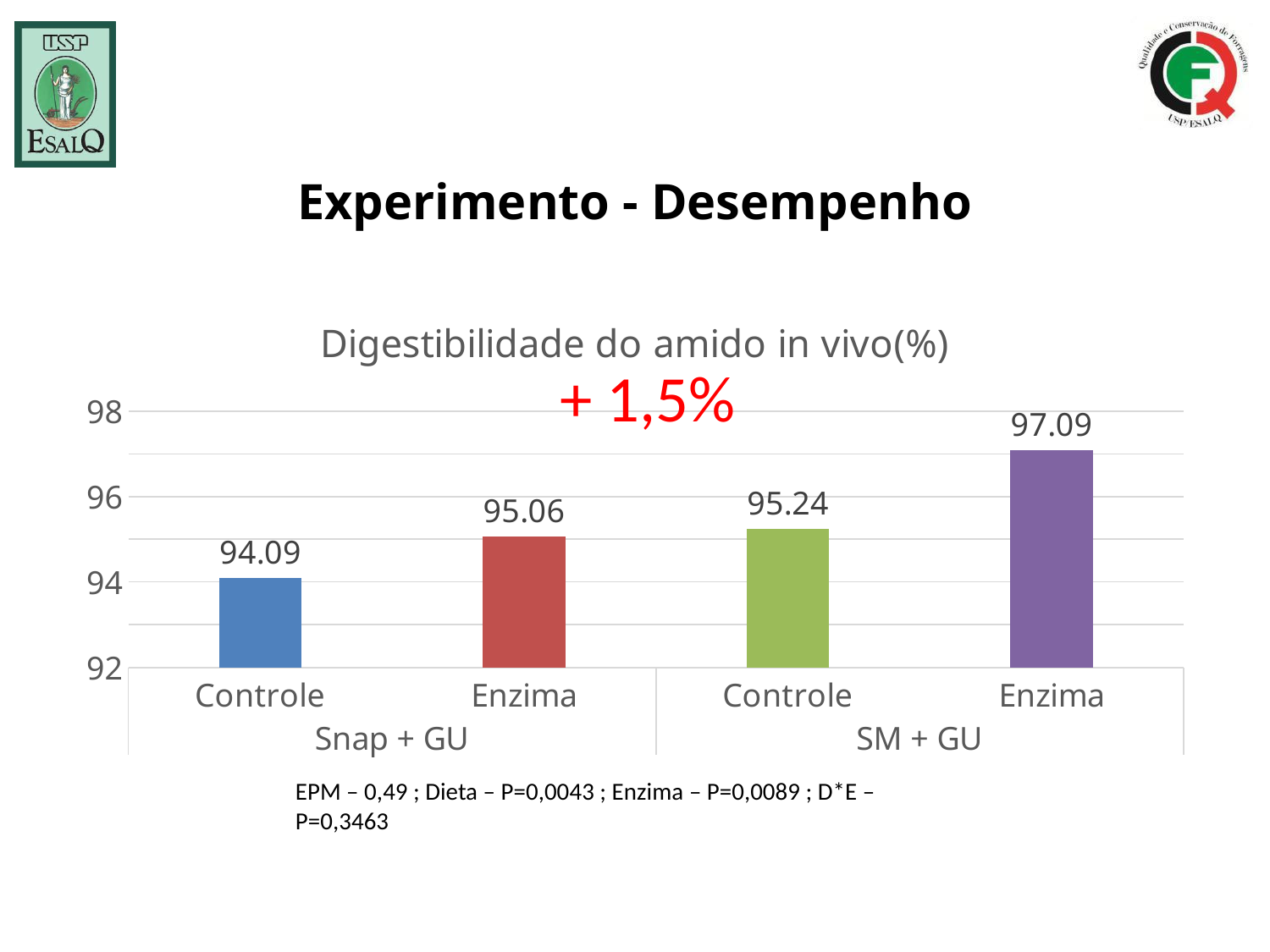
What is the value for Controle in the SM + GU group? 95.24 What is the value for Controle in the Snap + GU group? 94.09 Which bar has the highest value? Enzima (SM + GU) Which is larger: Enzima in Snap + GU or Controle in SM + GU? Controle in SM + GU What is the value for Enzima in the SM + GU group? 97.09 Which bar has the lowest value? Controle (Snap + GU) What is the title of the chart? Digestibilidade do amido in vivo(%) What is the difference between Enzima and Controle in the SM + GU group? 1.85 What is the value for Enzima in the Snap + GU group? 95.06 What kind of chart is shown? Bar chart What is the difference between Enzima and Controle in the Snap + GU group? 0.97 How many bars are plotted in the chart? 4